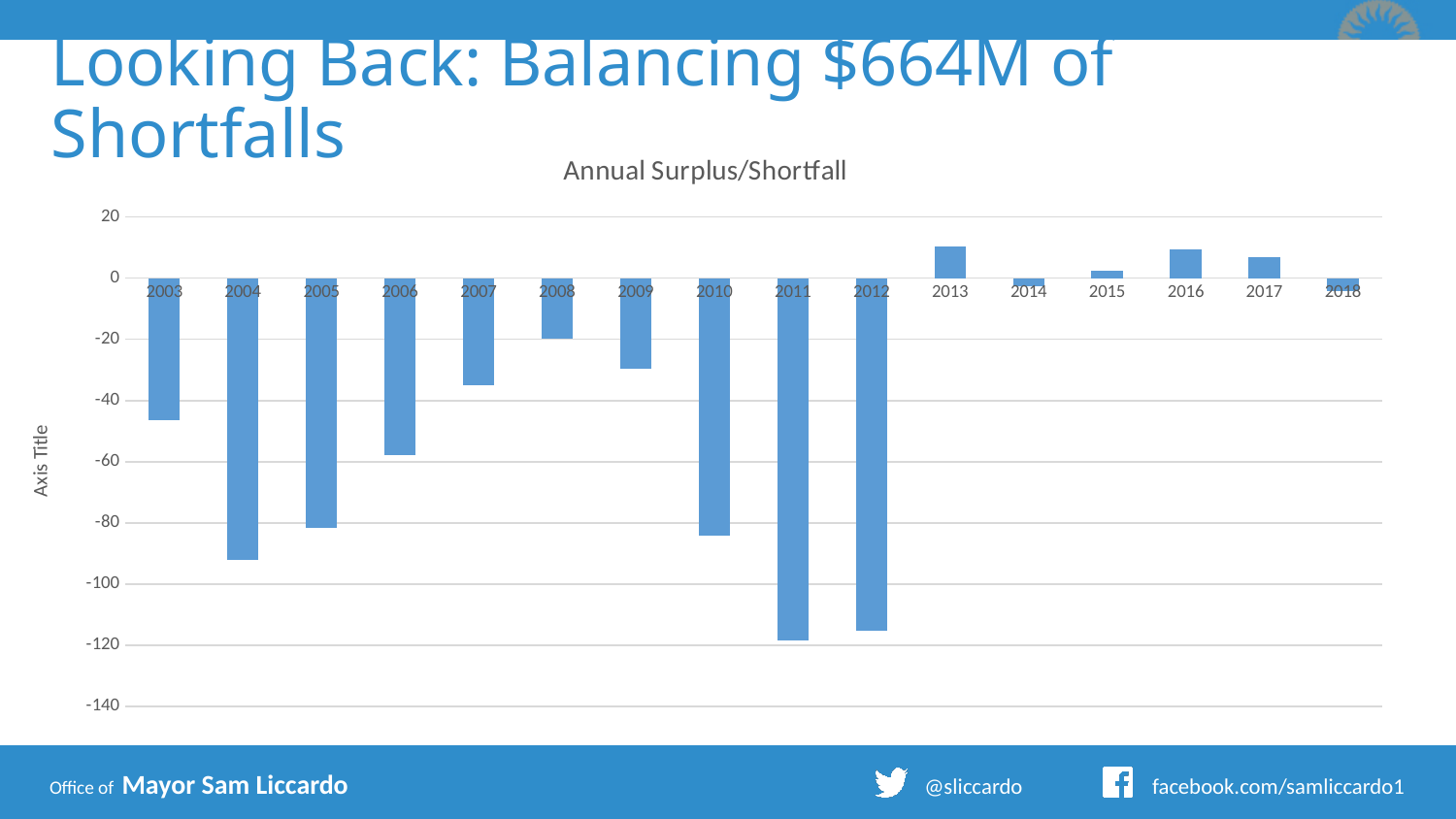
Is the value for 2007 greater or less than -40? greater Is the value for 2011 greater or less than -100? less Do the values rise or fall from 2010 to 2013? rise Is the value for 2013 greater or less than 0? greater What kind of chart is shown on the slide? bar chart How many years are plotted on the x axis of the chart? 16 What is the title of the chart? Annual Surplus/Shortfall Which year has the larger value, 2008 or 2011? 2008 Which year has the larger value, 2004 or 2007? 2007 Which year has the larger value, 2013 or 2014? 2013